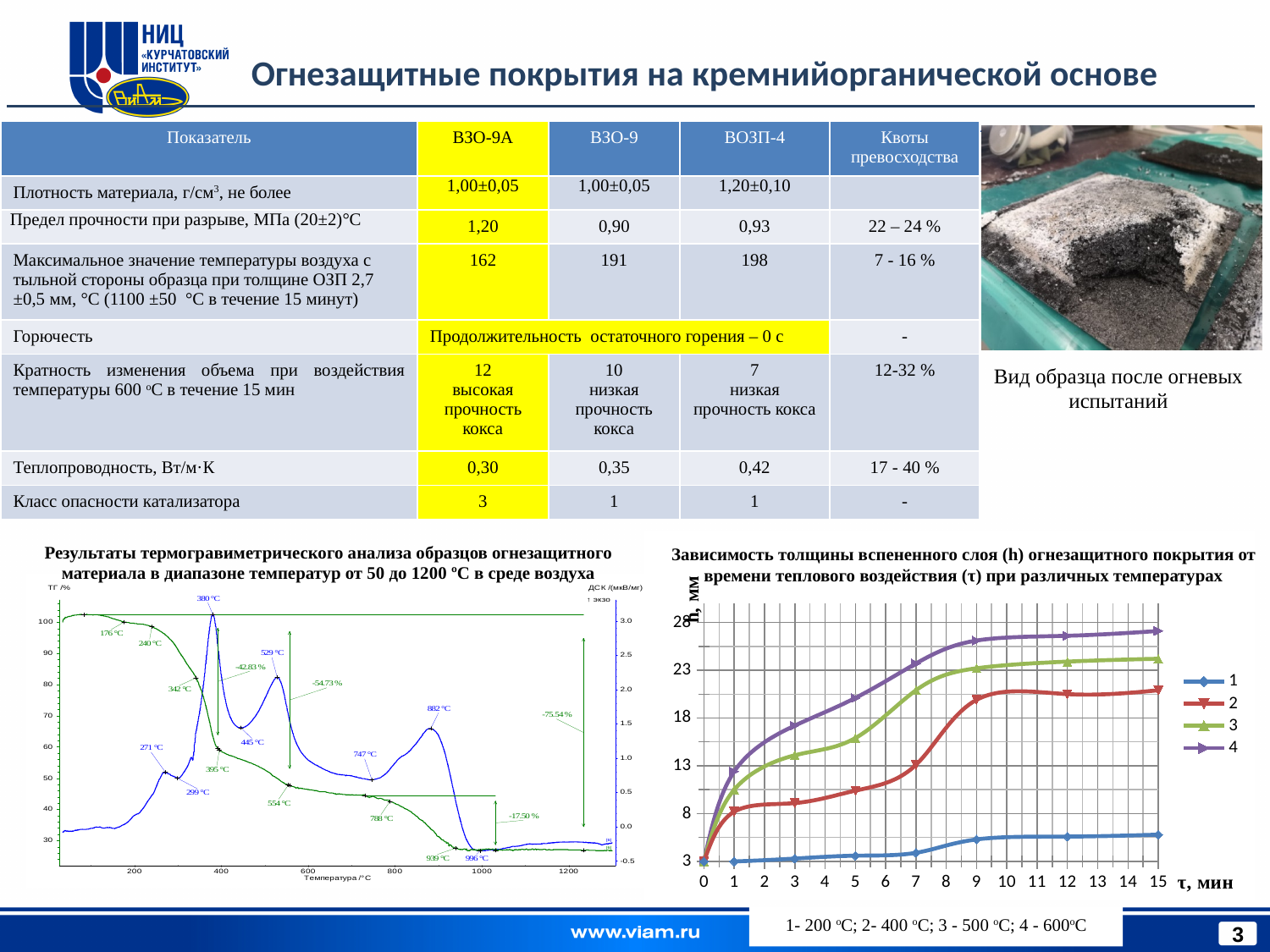
In the right-hand chart of foamed layer thickness versus time, is the value of series 4 at 15 min greater or less than 23? greater In the left-hand thermogravimetric analysis chart, what temperature is labeled at the tallest peak of the DSC curve? 380 °C In the right-hand chart of foamed layer thickness versus time, which series has the lowest thickness at 15 min? 1 In the right-hand chart of foamed layer thickness versus time, is the value of series 1 at 15 min greater or less than 8? less In the right-hand chart of foamed layer thickness versus time, do the values of series 4 rise or fall as time increases from 0 to 15 min? rise In the right-hand chart of foamed layer thickness versus time, is the value of series 2 at 15 min greater or less than 18? greater In the right-hand chart of foamed layer thickness versus time, how many series does the legend list? 4 What kind of chart is the left-hand chart showing the results of thermogravimetric analysis? line chart In the right-hand chart of foamed layer thickness versus time, which series reaches the highest thickness at 15 min? 4 In the right-hand chart of foamed layer thickness versus time, which is larger at 9 min: series 2 or series 3? series 3 What kind of chart is the right-hand chart showing the dependence of foamed layer thickness (h) on time (τ)? line chart In the right-hand chart of foamed layer thickness versus time, what temperature does series 4 correspond to according to the caption below the chart? 600 °C